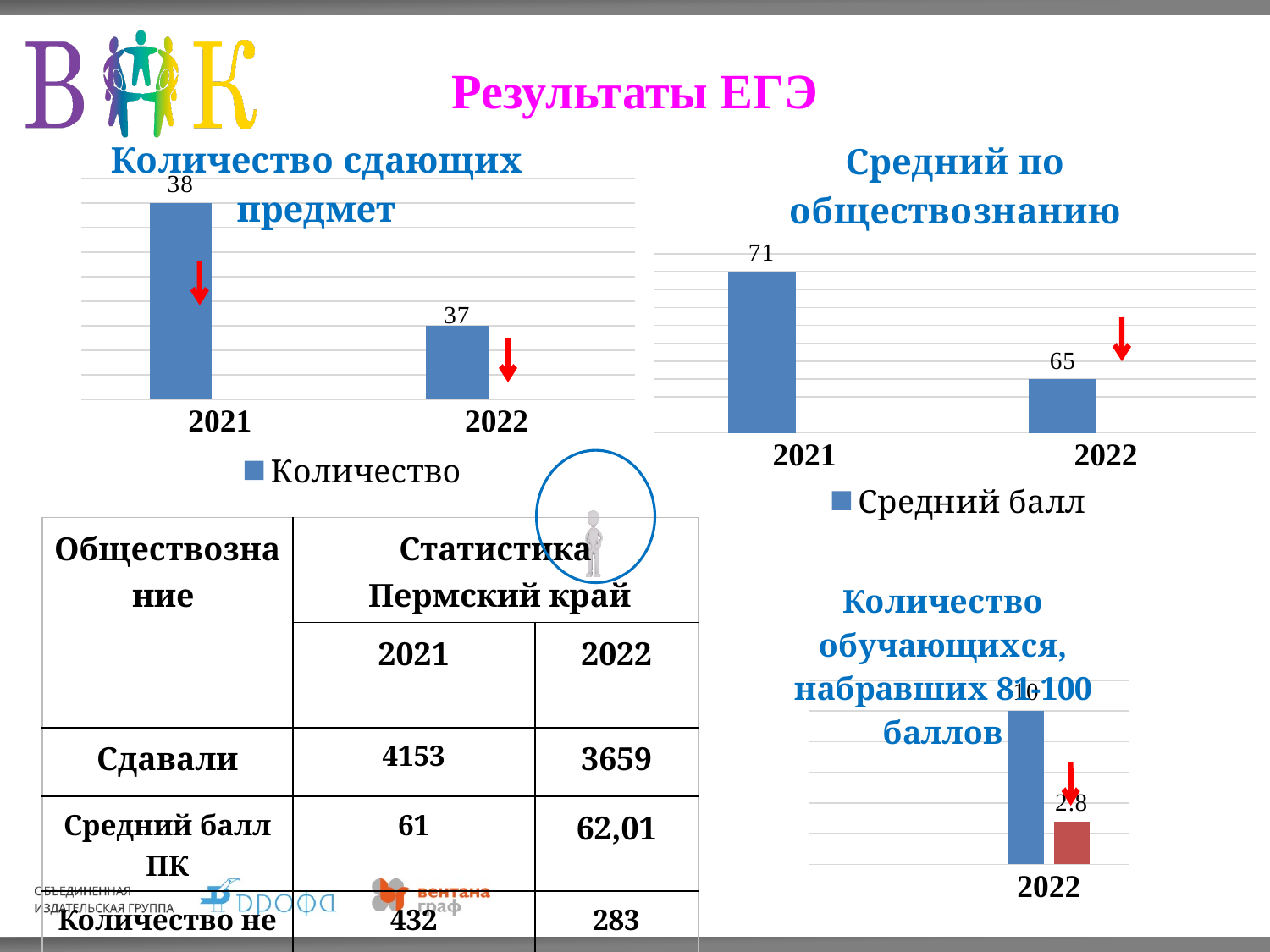
In the chart 'Средний по обществознанию', how many series does the legend list? 1 In the chart 'Средний по обществознанию', which year has the higher value? 2021 In the chart 'Средний по обществознанию', what is the value for 2021? 71 In the chart 'Количество обучающихся, набравших 81-100 баллов', what value is labelled on the red bar? 2.8 In the chart 'Количество сдающих предмет', what is the difference between the 2021 and 2022 values? 1 In the chart 'Средний по обществознанию', by how much did the value fall from 2021 to 2022? 6 In the chart 'Количество сдающих предмет', what series name does the legend show? Количество What type of chart is 'Количество сдающих предмет'? bar chart In the chart 'Количество сдающих предмет', what is the value for 2022? 37 In the chart 'Средний по обществознанию', do the values rise or fall from 2021 to 2022? fall In the chart 'Средний по обществознанию', what is the value for 2022? 65 In the chart 'Количество сдающих предмет', what is the value for 2021? 38